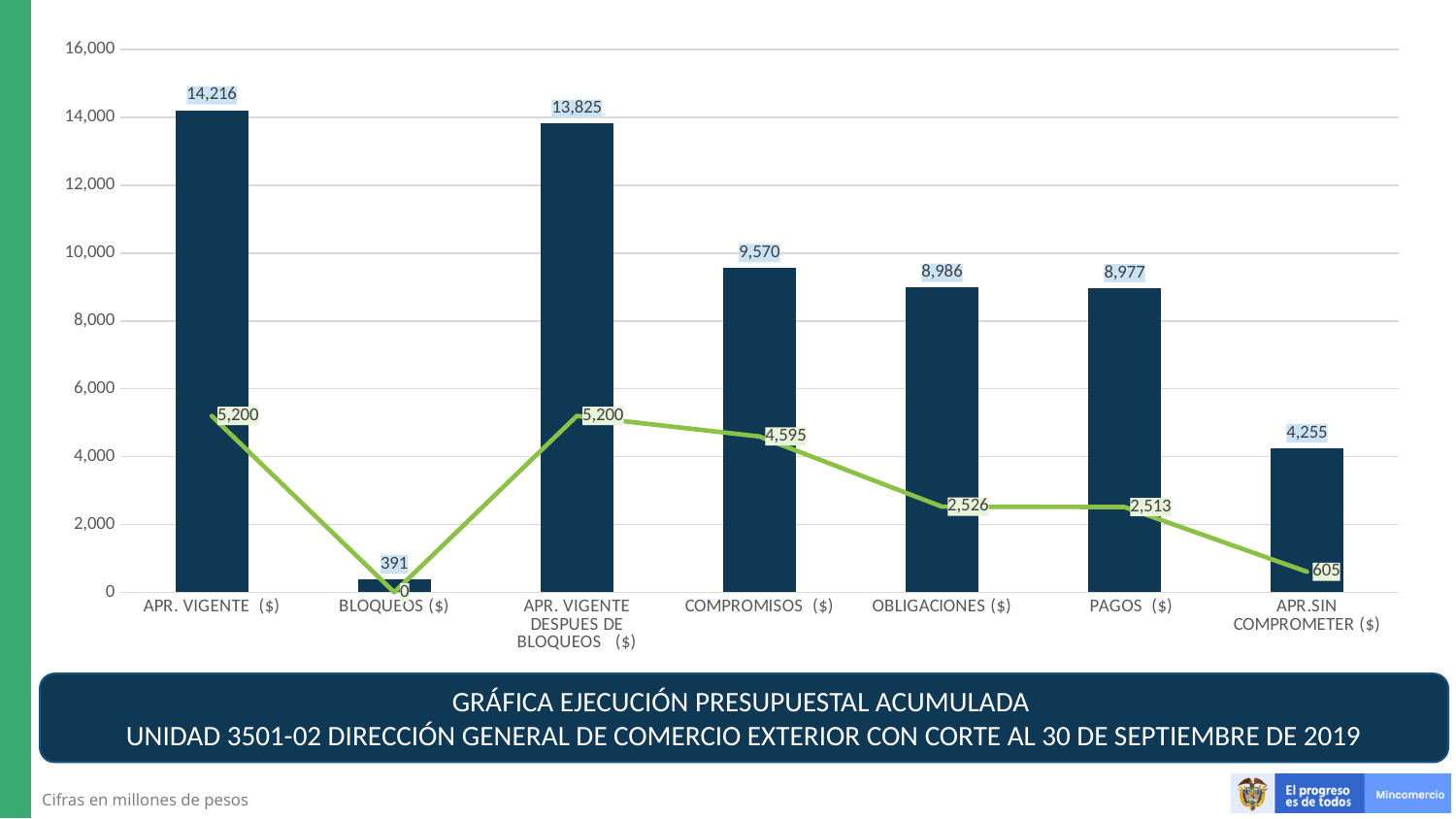
Which is larger, the bar for COMPROMISOS ($) or the bar for APR.SIN COMPROMETER ($)? COMPROMISOS ($) What is the bar value for APR.SIN COMPROMETER ($)? 4,255 Which category has the lowest bar? BLOQUEOS ($) What is the difference between the bar value and the green line value at PAGOS ($)? 6,464 What kind of chart is this? Combined bar and line chart Which category has the highest bar? APR. VIGENTE ($) What is the value of the green line at OBLIGACIONES ($)? 2,526 What is the bar value for APR. VIGENTE ($)? 14,216 What is the difference between the bar values for APR. VIGENTE ($) and APR. VIGENTE DESPUES DE BLOQUEOS ($)? 391 What is the value of the green line at BLOQUEOS ($)? 0 What is the bar value for COMPROMISOS ($)? 9,570 How many categories are shown on the x axis? 7